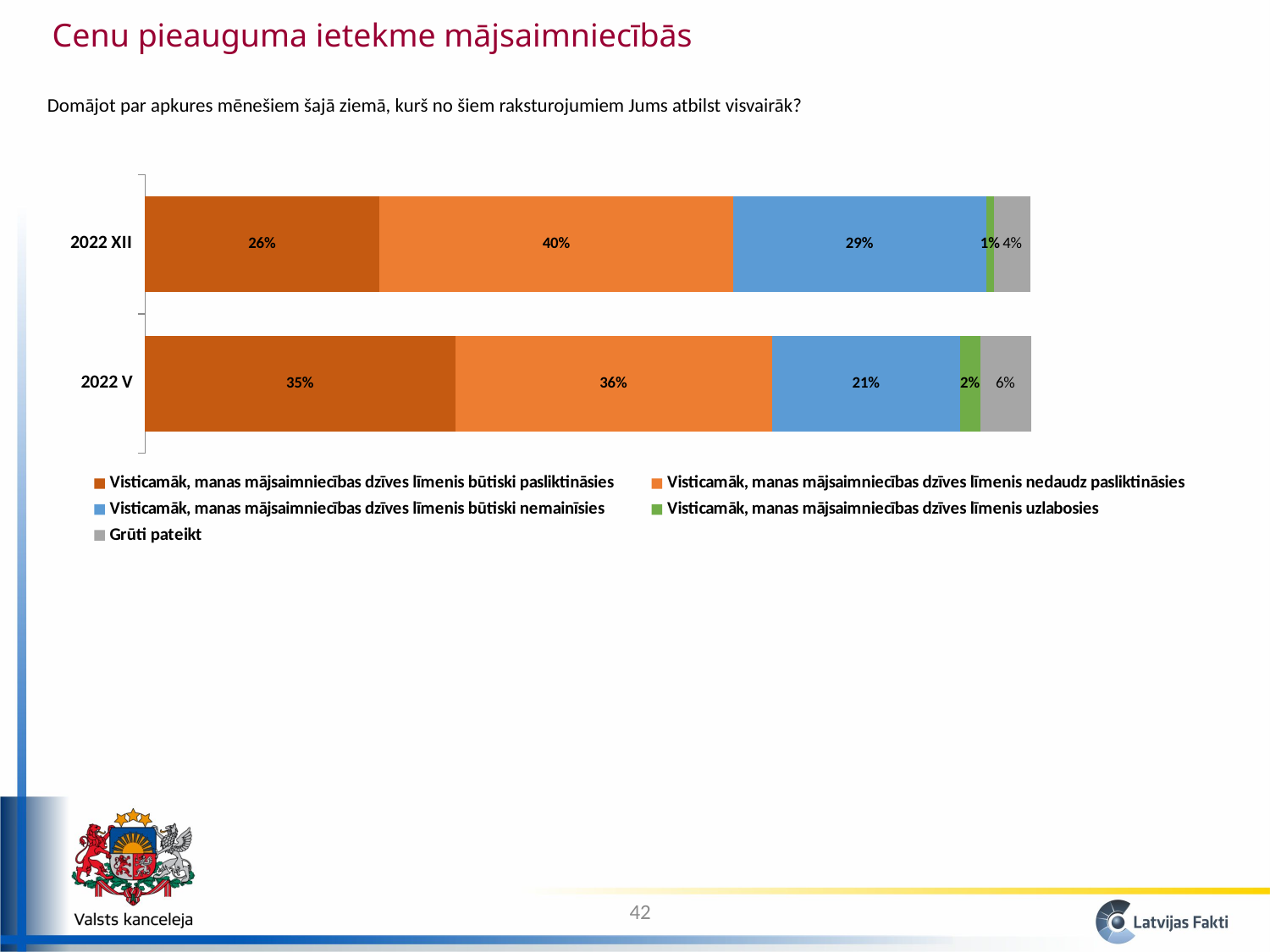
Which series has the highest value in 2022 XII? Visticamāk, manas mājsaimniecības dzīves līmenis nedaudz pasliktināsies How many categories (time periods) are plotted on the chart? 2 What is the value for "Visticamāk, manas mājsaimniecības dzīves līmenis nedaudz pasliktināsies" in 2022 V? 36% Which series has the lowest value in 2022 V? Visticamāk, manas mājsaimniecības dzīves līmenis uzlabosies What is the value for "Visticamāk, manas mājsaimniecības dzīves līmenis būtiski pasliktināsies" in 2022 XII? 26% What is the difference between the "būtiski pasliktināsies" values for 2022 V and 2022 XII? 9 percentage points What is the value for "Visticamāk, manas mājsaimniecības dzīves līmenis uzlabosies" in 2022 V? 2% What is the title of the slide containing the chart? Cenu pieauguma ietekme mājsaimniecībās What is the value for "Grūti pateikt" in 2022 XII? 4% Which period has the larger value for "Visticamāk, manas mājsaimniecības dzīves līmenis būtiski nemainīsies", 2022 XII or 2022 V? 2022 XII How many series does the legend list? 5 What kind of chart is shown on the slide? Stacked bar chart